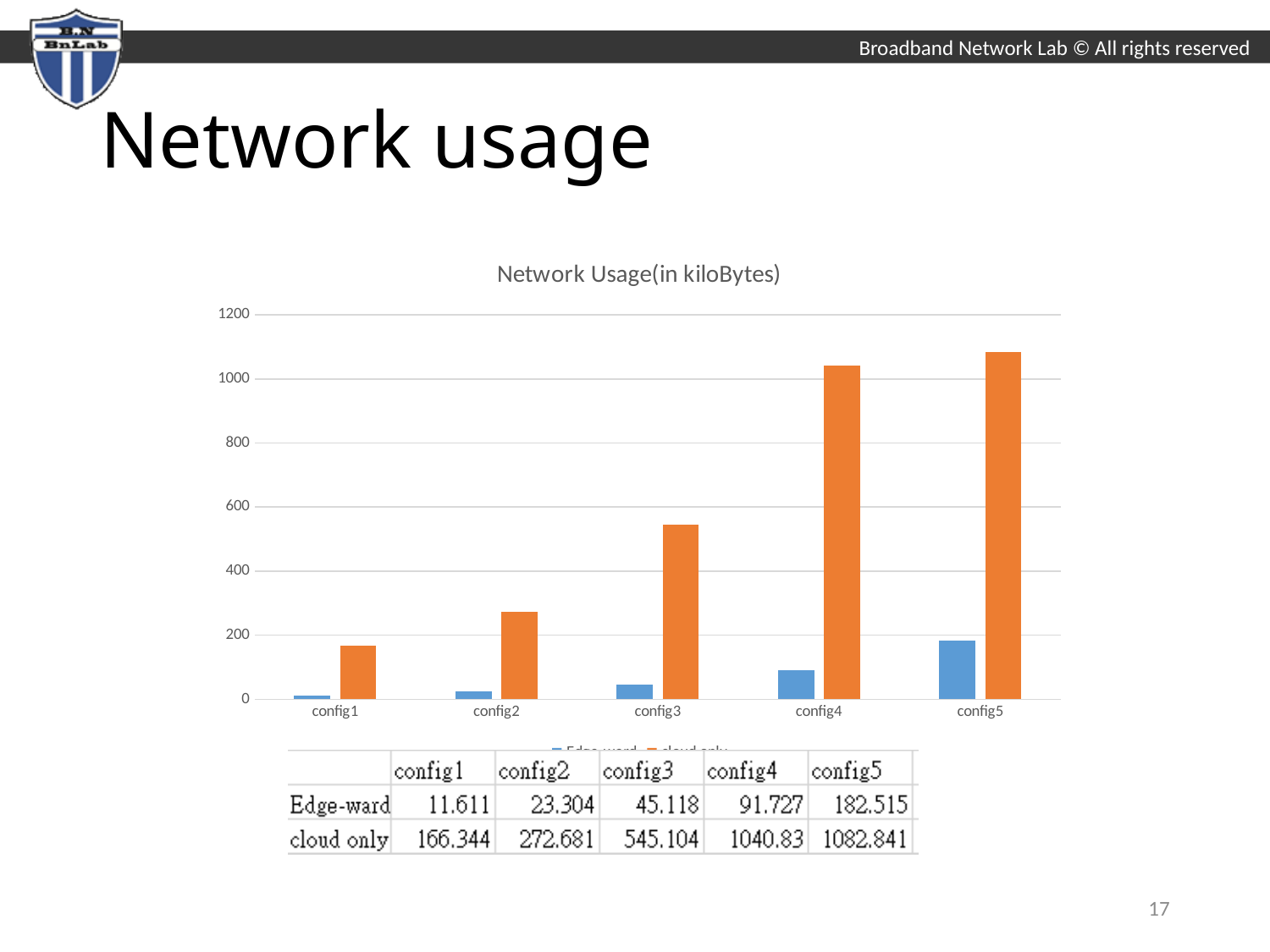
How many data series are plotted in the chart? 2 Which is larger for config2: the Edge-ward value or the cloud only value? cloud only Do the cloud only values rise or fall from config1 to config5? rise What type of chart is shown on the slide? bar chart What is the title of the chart? Network Usage(in kiloBytes) What is the difference between the cloud only values for config5 and config4? 42.011 What is the Edge-ward value for config5? 182.515 Which configuration has the highest cloud only value? config5 What is the cloud only value for config4? 1040.83 Which configuration has the lowest Edge-ward value? config1 How many configurations are shown on the x axis of the chart? 5 What is the cloud only value for config3? 545.104